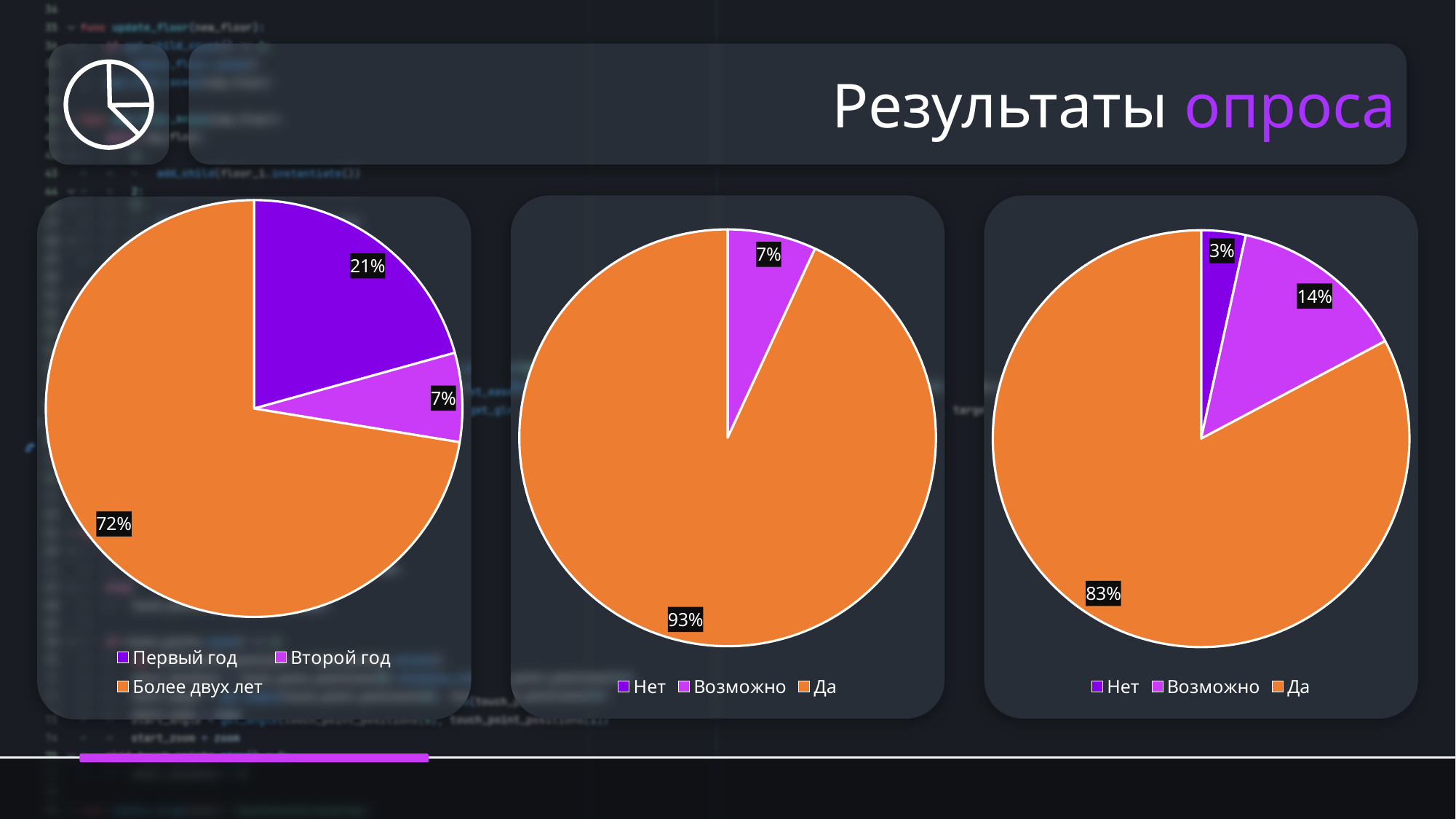
On the right pie chart, what share is labelled for Возможно? 14% What type of chart is used for the three charts on the slide? pie chart On the right pie chart, is the slice for Возможно larger or smaller than the slice for Нет? larger On the right pie chart, which category has the largest slice? Да On the left pie chart, what share is labelled for Более двух лет? 72% On the right pie chart, what share is labelled for Нет? 3% On the left pie chart, what share is labelled for Первый год? 21% On the middle pie chart, what share is labelled for Да? 93% On the middle pie chart, how many entries does the legend list? 3 On the middle pie chart, what share is labelled for Возможно? 7% On the left pie chart, what is the difference in percentage points between Более двух лет and Первый год? 51 On the left pie chart, which category has the smallest slice? Второй год